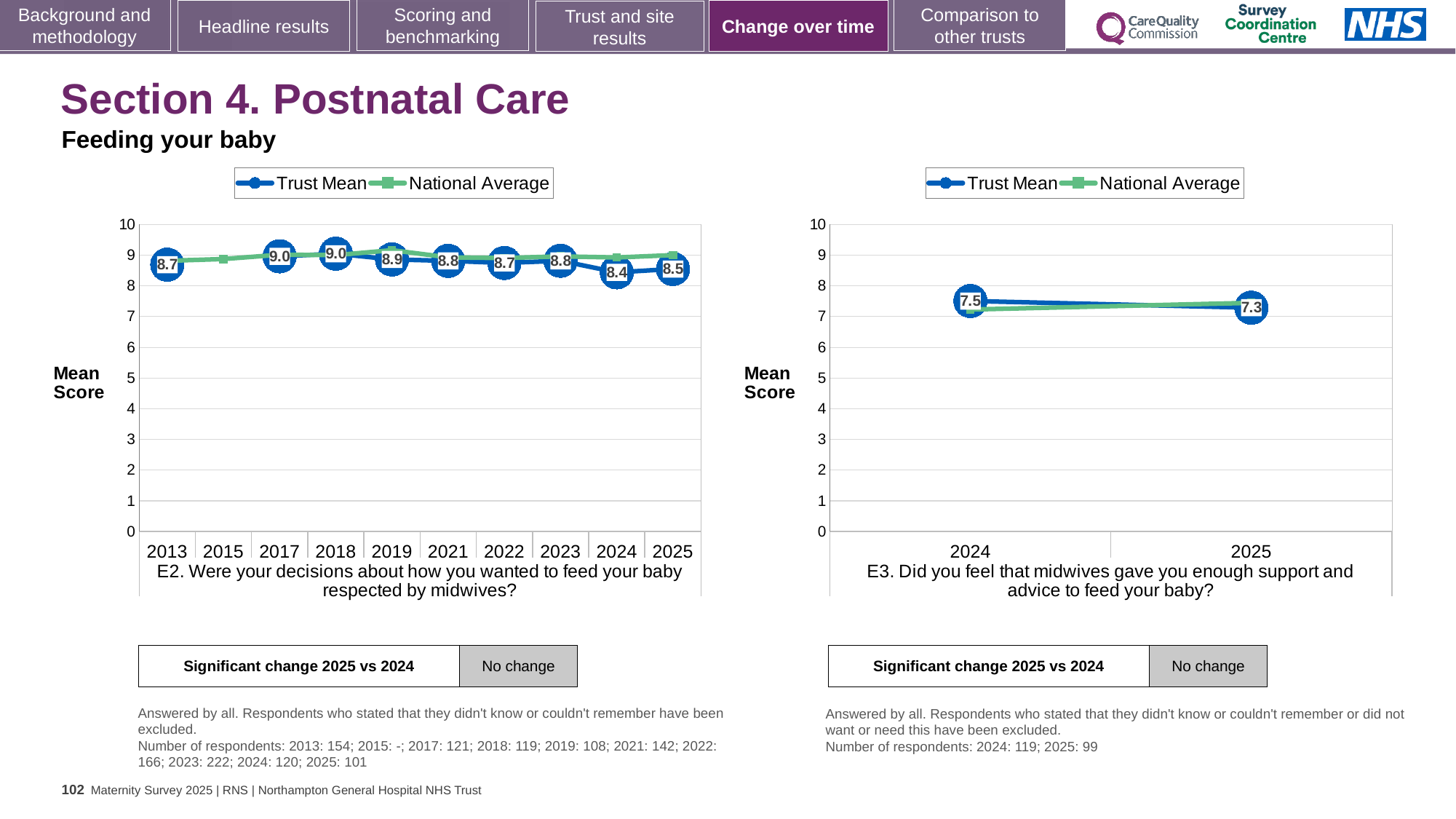
In the E3 chart on the right, which year has the higher Trust Mean? 2024 In the E2 chart on the left, what is the Trust Mean for 2013? 8.7 In the E2 chart on the left, is the Trust Mean for 2013 larger or smaller than the Trust Mean for 2024? larger In the E2 chart on the left, what is the Trust Mean for 2024? 8.4 How many series does the legend of the E3 chart on the right list? 2 In the E3 chart on the right, what is the difference between the Trust Mean for 2024 and 2025? 0.2 In the E2 chart on the left, which year has the lowest Trust Mean? 2024 In the E2 chart on the left, how many years are shown on the x axis? 10 What kind of chart is the E2 chart on the left? line chart In the E2 chart on the left, what is the Trust Mean for 2025? 8.5 In the E2 chart on the left, is the National Average for 2025 greater or less than 8? greater In the E3 chart on the right, what is the Trust Mean for 2025? 7.3